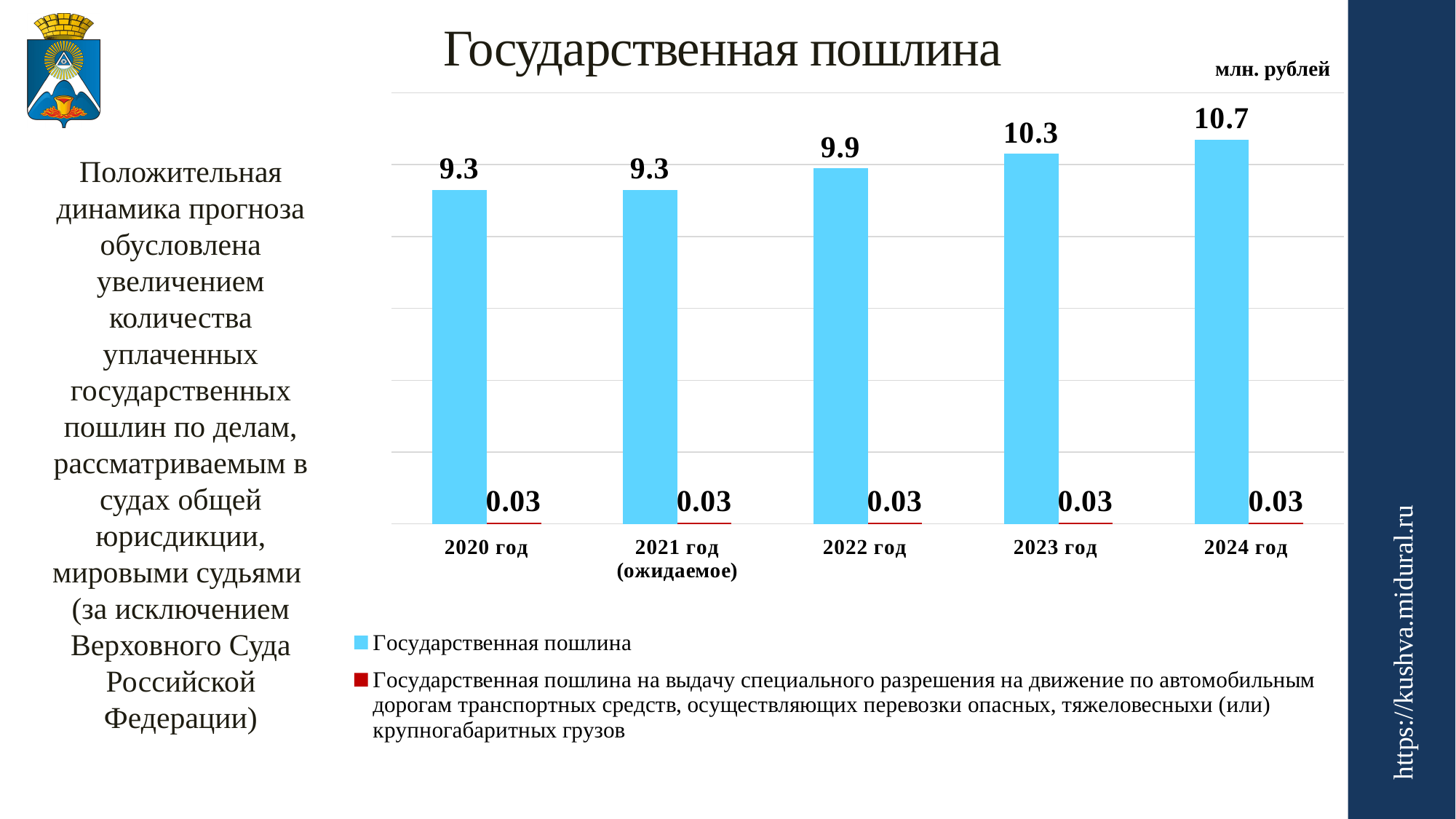
What is the value of the 'Государственная пошлина' series for 2022 год? 9.9 What is the difference between the 'Государственная пошлина' values for 2024 год and 2020 год? 1.4 What unit of measurement is indicated for the chart? млн. рублей What is the value of the red series (Государственная пошлина на выдачу специального разрешения...) for 2021 год (ожидаемое)? 0.03 Which is larger: the 'Государственная пошлина' value for 2023 год or for 2021 год (ожидаемое)? 2023 год What is the value of the 'Государственная пошлина' series for 2024 год? 10.7 What kind of chart is shown on the slide? Bar chart In which year is the 'Государственная пошлина' series highest? 2024 год How many series does the legend list? 2 What is the difference between the 'Государственная пошлина' values for 2023 год and 2022 год? 0.4 How many years (categories) are shown on the x axis? 5 Does the 'Государственная пошлина' series rise or fall from 2020 год to 2024 год? Rises